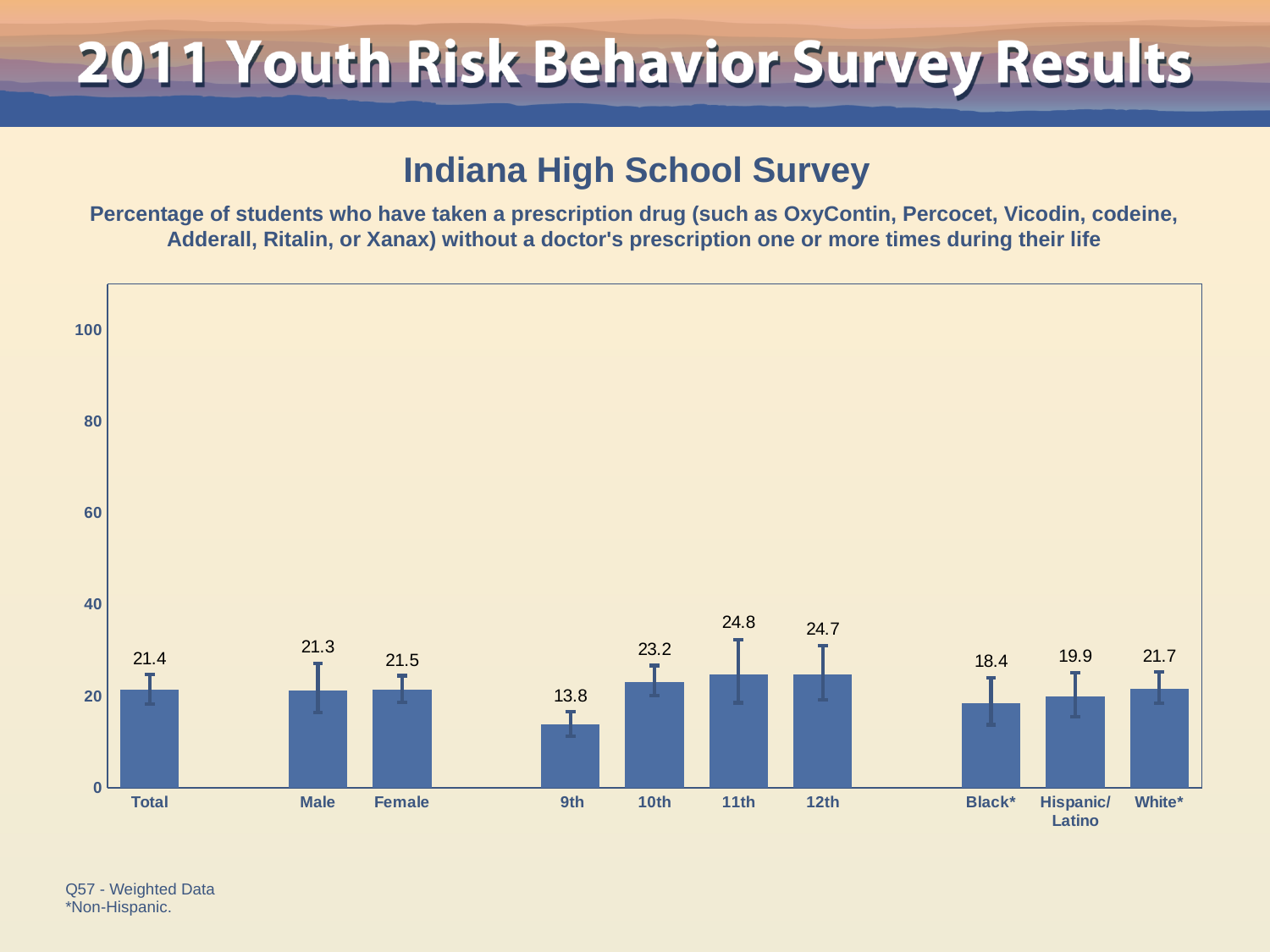
What is the value for 9th grade? 13.8 What is the value for Total? 21.4 What kind of chart is this? bar chart Is the value for 12th grade greater or less than 20? greater Which is larger, the value for 10th grade or the value for Black*? 10th How many categories are shown on the x axis? 10 What is the value for Hispanic/Latino students? 19.9 Which category has the lowest value? 9th Which category has the highest value? 11th Do the values rise or fall from 9th grade to 11th grade? rise What is the difference between the values for 11th and 9th grade? 11.0 What is the difference between the values for White* and Black*? 3.3